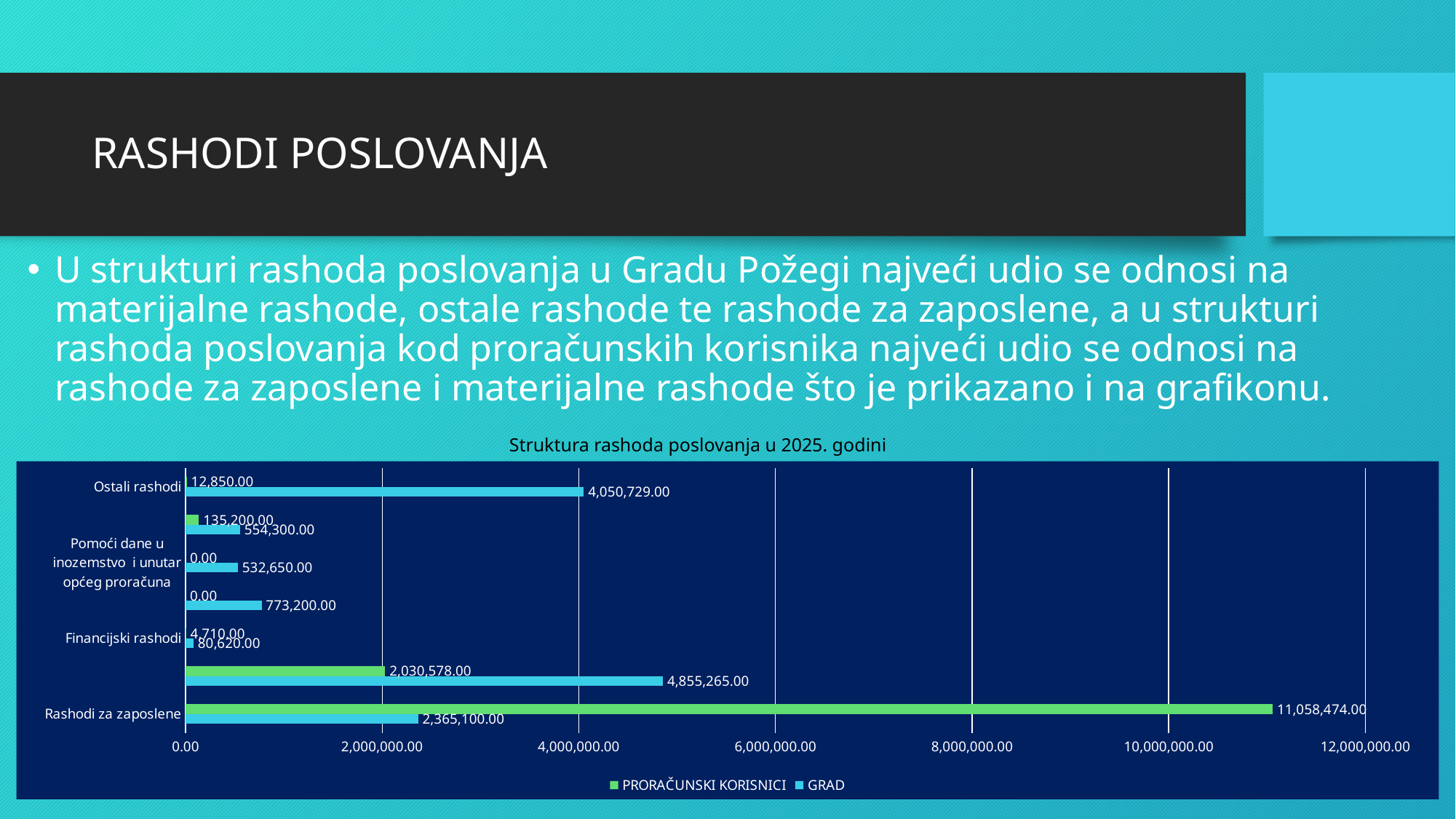
What is the title of the chart? Struktura rashoda poslovanja u 2025. godini What kind of chart is shown on the slide? bar chart For Ostali rashodi, which series has the larger value, PRORAČUNSKI KORISNICI or GRAD? GRAD What is the GRAD value for Ostali rashodi? 4,050,729.00 Which category has the highest PRORAČUNSKI KORISNICI value? Rashodi za zaposlene What is the GRAD value for Rashodi za zaposlene? 2,365,100.00 For Rashodi za zaposlene, what is the difference between the PRORAČUNSKI KORISNICI value and the GRAD value? 8,693,374.00 Is the GRAD value for Ostali rashodi greater or less than 4,000,000.00? greater How many series does the chart legend list? 2 What is the PRORAČUNSKI KORISNICI value for Financijski rashodi? 4,710.00 What is the PRORAČUNSKI KORISNICI value for Rashodi za zaposlene? 11,058,474.00 What is the GRAD value for Financijski rashodi? 80,620.00